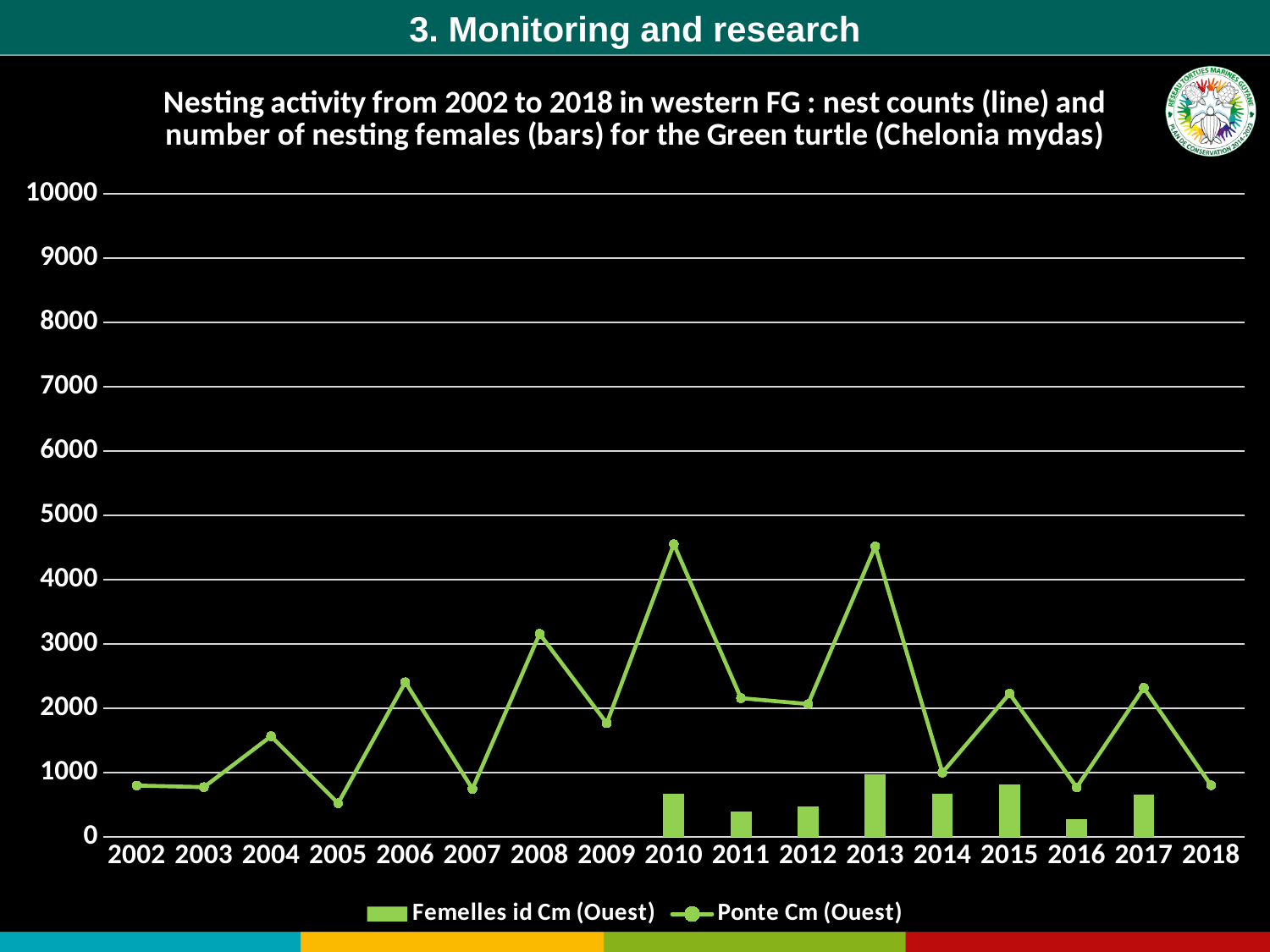
Which series is drawn as bars according to the legend? Femelles id Cm (Ouest) Which year has the tallest Femelles id Cm (Ouest) bar? 2013 Is the Ponte Cm (Ouest) value for 2005 greater or less than 1000? less Is the Ponte Cm (Ouest) value for 2010 greater or less than 4000? greater What kind of chart is this? Combined line and bar chart Is the Ponte Cm (Ouest) value for 2008 greater or less than 3000? greater Which year has the lowest value for the Ponte Cm (Ouest) line? 2005 Which year has a higher Ponte Cm (Ouest) value, 2006 or 2009? 2006 How many series does the legend list? 2 How many years are shown along the x axis? 17 Which year has the shortest Femelles id Cm (Ouest) bar? 2016